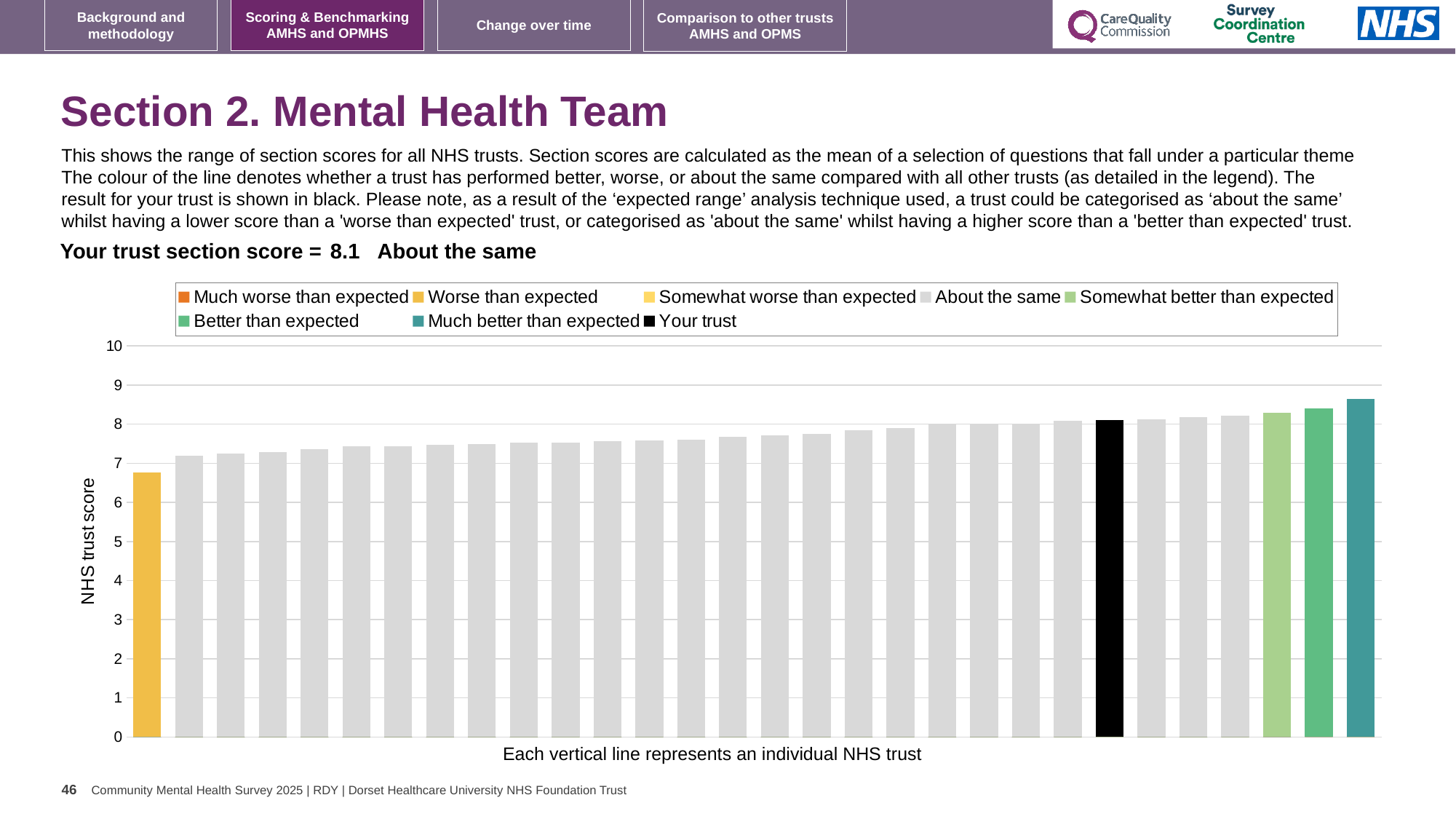
Which legend category does the highest bar on the chart belong to? Much better than expected Do the bar values rise or fall from left to right along the x axis? Rise How many bars on the chart are coloured as 'Much worse than expected'? 0 Is the value of the leftmost (yellow) bar greater or less than 7? less What kind of chart is shown on the slide? Bar chart What is the section score for your trust shown on the slide? 8.1 Is the value of the rightmost (teal) bar greater or less than 8? greater Which performance category is your trust's section score placed in? About the same Which is higher, the black 'Your trust' bar or the yellow 'Worse than expected' bar? The black 'Your trust' bar How many entries does the chart legend list? 8 Which legend category does the lowest bar on the chart belong to? Worse than expected Is the value of the black 'Your trust' bar greater or less than 7? greater